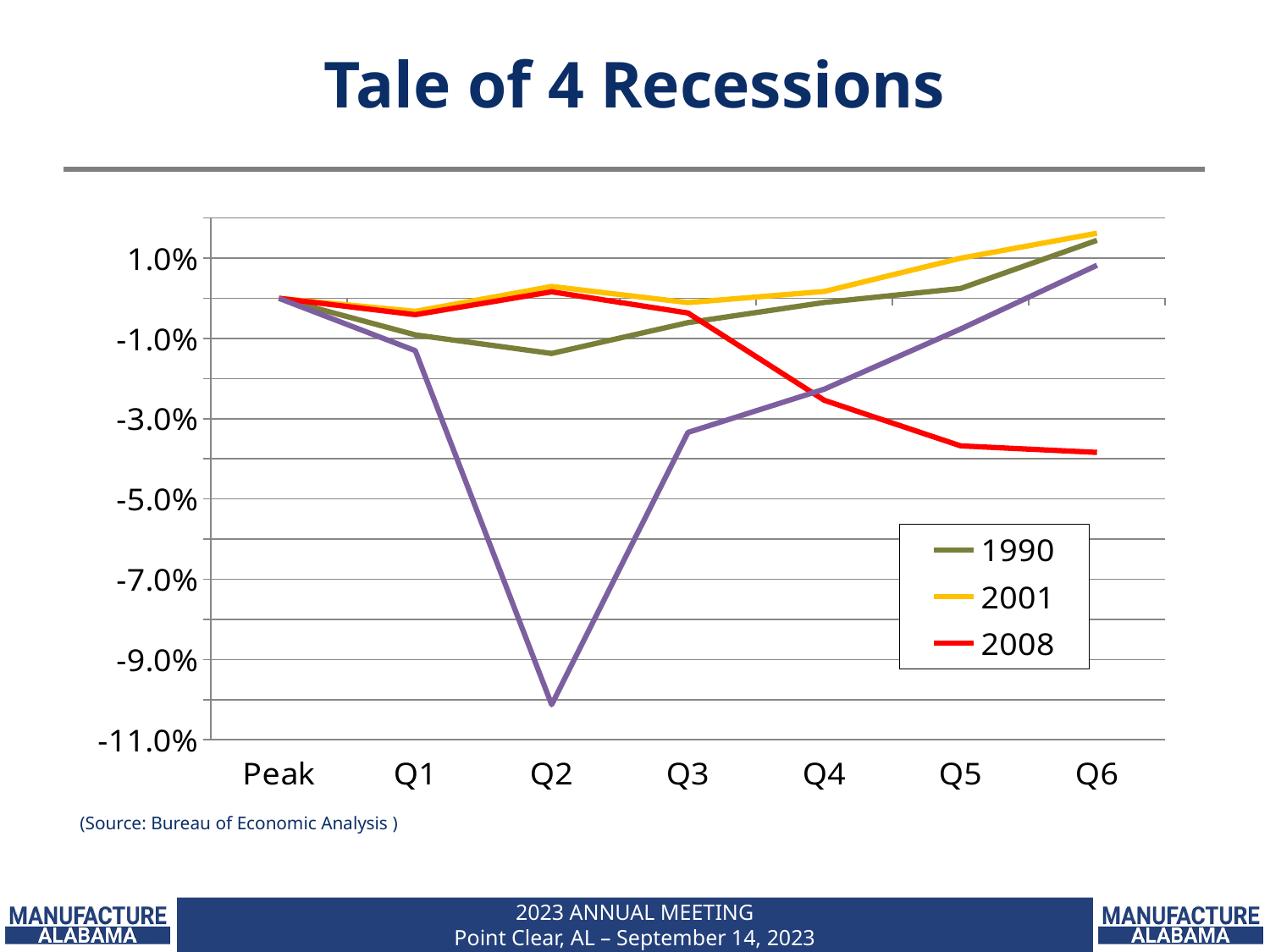
Is the value for the 2008 series at Q6 greater or less than -3.0%? less Does the 2008 series rise or fall from Q3 to Q6? fall At Q6, which series has the lowest value? 2008 Is the value for the 2001 series at Q6 greater or less than 1.0%? greater How many points are on the x axis of the chart? 7 How many series does the legend list? 3 At Q6, which is larger: the 2001 series or the 2008 series? 2001 What is the title of the slide containing the chart? Tale of 4 Recessions What kind of chart is shown on the slide? line chart Is the value for the 2008 series at Q3 greater or less than -1.0%? greater Does the 1990 series rise or fall from Q2 to Q6? rise